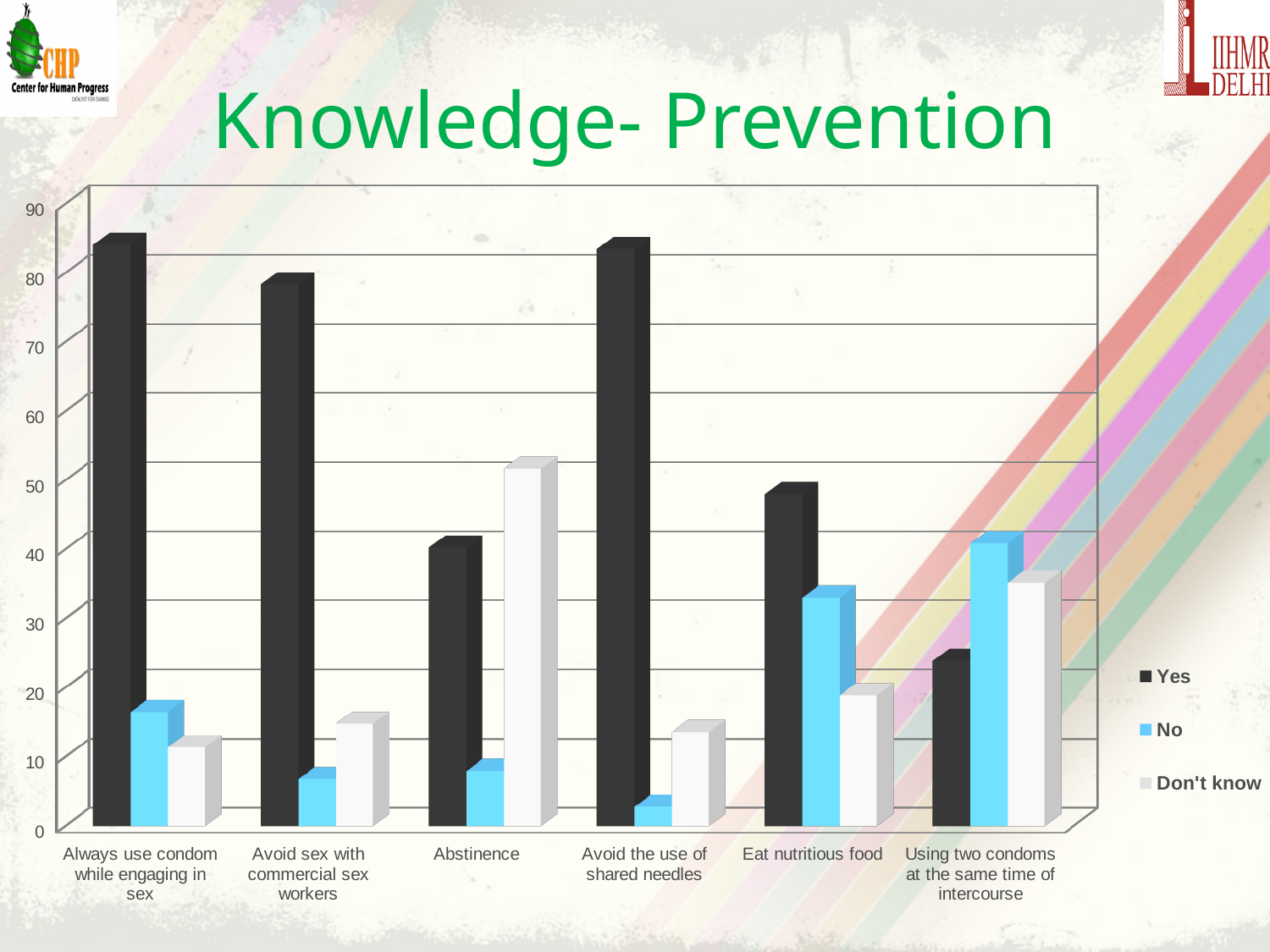
Which category has the highest 'Don't know' value? Abstinence What is the title of the slide containing the chart? Knowledge- Prevention Which category has the highest 'No' value? Using two condoms at the same time of intercourse Which category has the lowest 'Yes' value? Using two condoms at the same time of intercourse How many categories are shown on the x axis of the chart? 6 Is the 'Yes' value for Abstinence greater or less than 50? less For Eat nutritious food, which is larger: the 'Yes' value or the 'No' value? Yes Is the 'No' value for Using two condoms at the same time of intercourse greater or less than 30? greater What kind of chart is shown on the slide? bar chart Which category has the lowest 'No' value? Avoid the use of shared needles For Abstinence, which is larger: the 'Yes' value or the 'Don't know' value? Don't know How many series does the legend list? 3